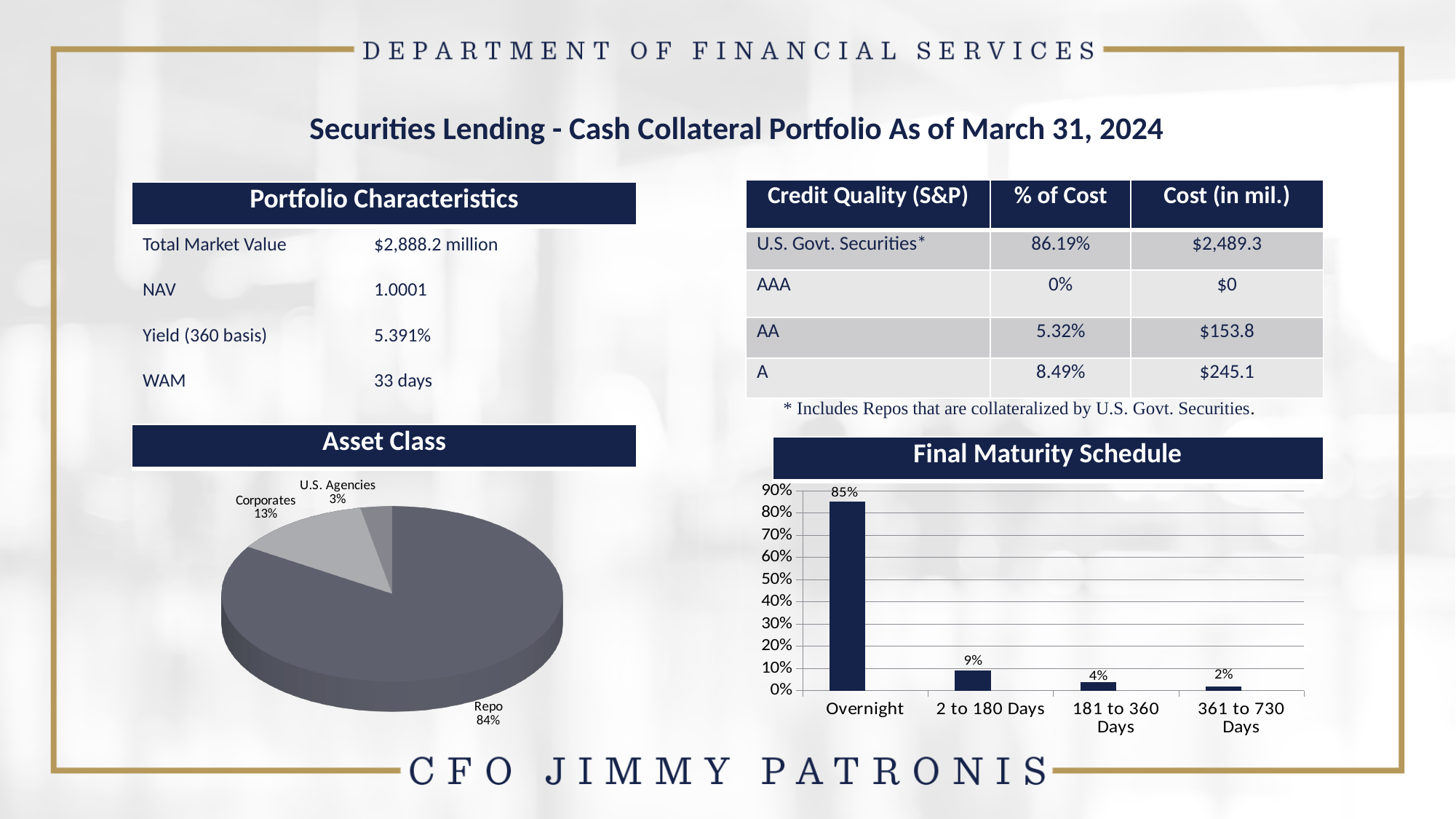
In the Final Maturity Schedule chart, which category has the lowest value? 361 to 730 Days In the Asset Class pie chart, what share does Repo have? 84% In the Final Maturity Schedule chart, what is the value for Overnight? 85% What kind of chart is the Asset Class chart? Pie chart In the Asset Class pie chart, which asset class has the smallest slice? U.S. Agencies How many slices does the Asset Class pie chart have? 3 What kind of chart is the Final Maturity Schedule chart? Bar chart In the Final Maturity Schedule chart, what is the value for 181 to 360 Days? 4% In the Asset Class pie chart, what share does Corporates have? 13% In the Final Maturity Schedule chart, do the values rise or fall from Overnight to 361 to 730 Days? Fall How many categories are shown on the x axis of the Final Maturity Schedule chart? 4 In the Final Maturity Schedule chart, what is the difference between the Overnight and 2 to 180 Days values? 76%